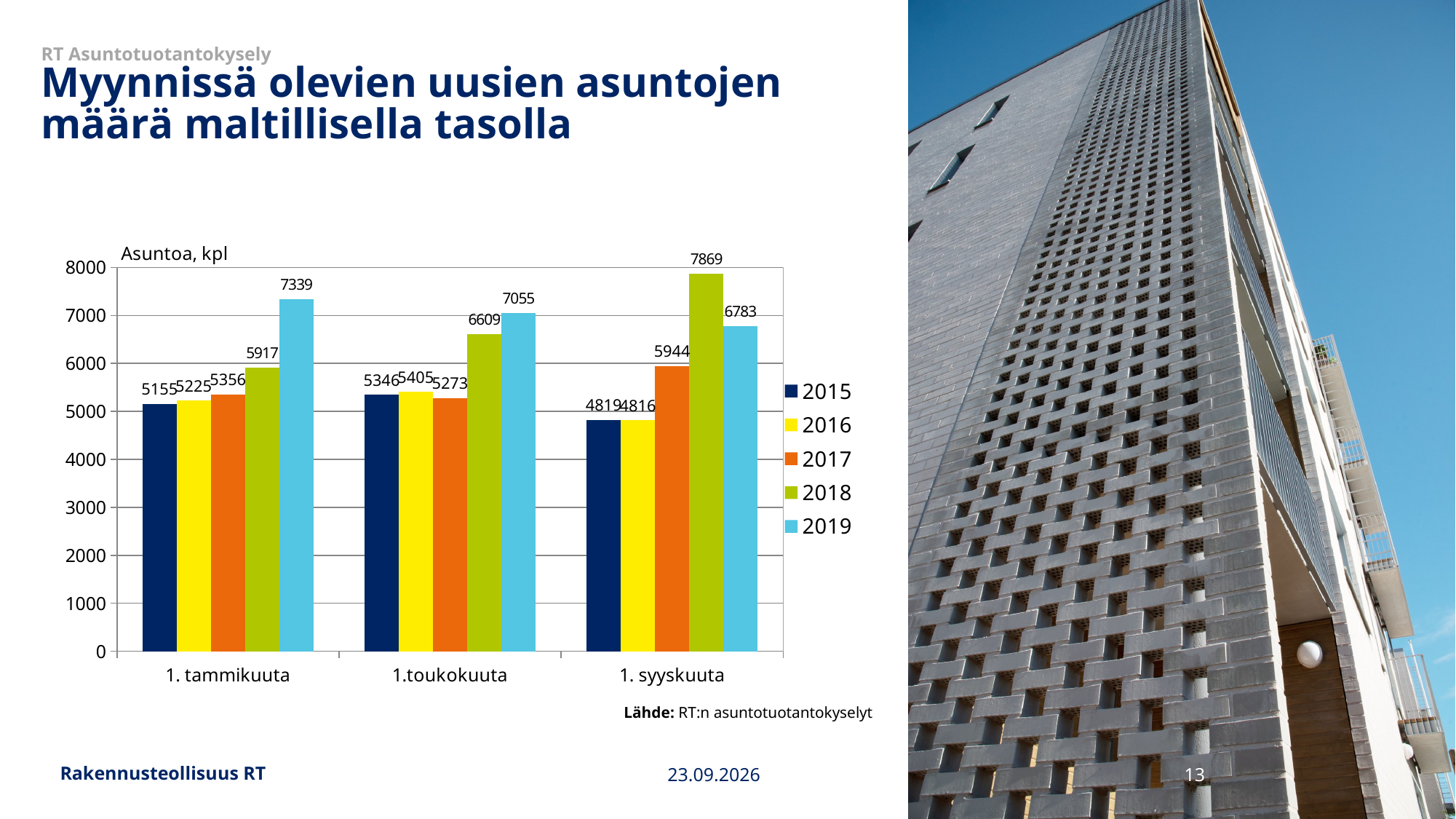
Which year has the highest value on 1.toukokuuta? 2019 What is the value for 2017 on 1.toukokuuta? 5273 Which is larger on 1. syyskuuta: the value for 2018 or the value for 2019? 2018 What is the value for 2019 on 1. tammikuuta? 7339 How many series does the legend list? 5 What unit label is shown above the y axis of the chart? Asuntoa, kpl What is the value for 2015 on 1. syyskuuta? 4819 What is the difference between the 2019 and 2018 values on 1. tammikuuta? 1422 How many categories are shown on the x axis? 3 Which year has the lowest value on 1. tammikuuta? 2015 What is the value for 2018 on 1. syyskuuta? 7869 What kind of chart is shown on the slide? bar chart